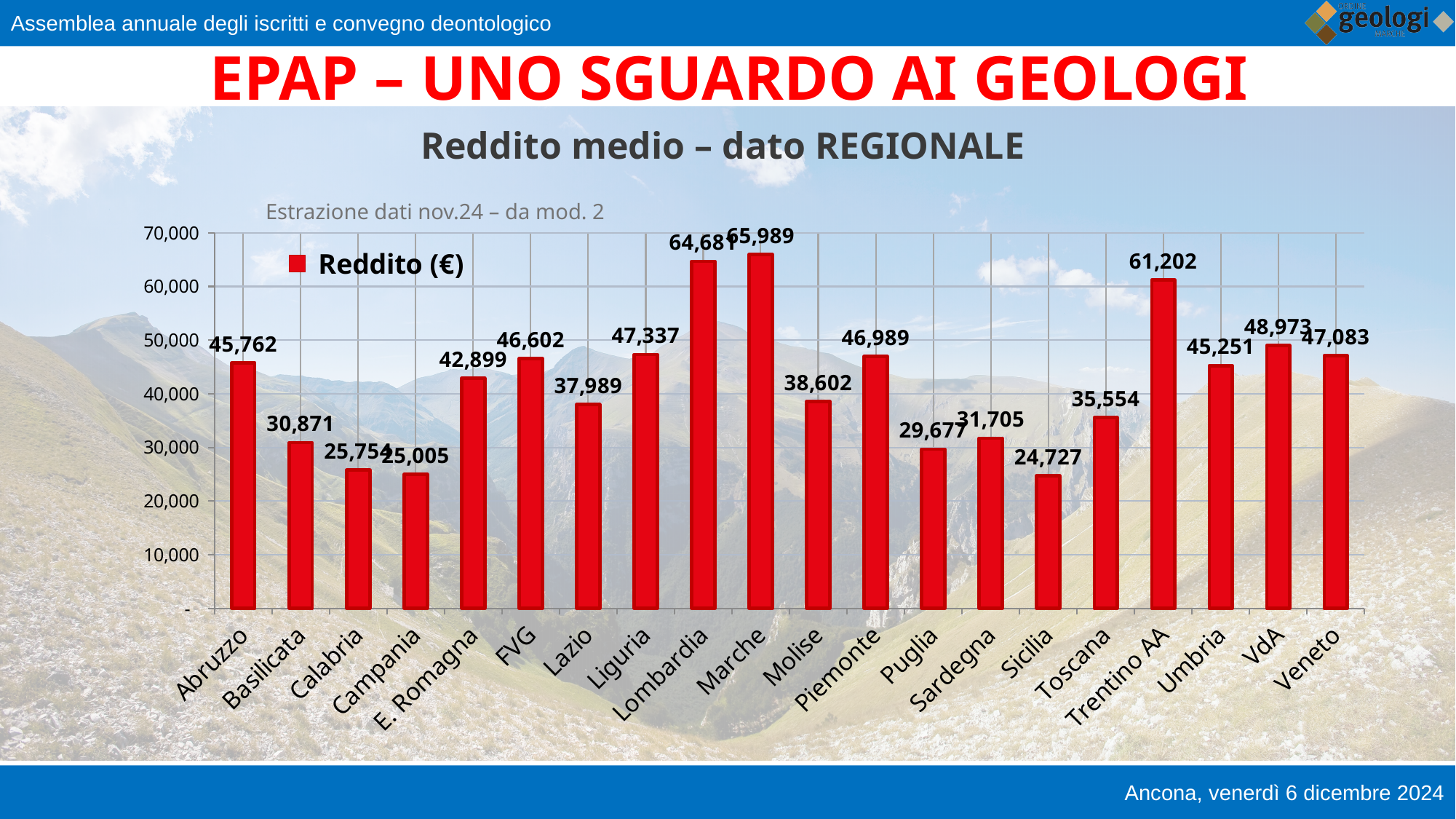
What is the difference between the values for Marche and Lombardia? 1,308 What is the value for Sardegna? 31,705 Which is larger, the value for Lombardia or the value for Trentino AA? Lombardia What is the value for Trentino AA? 61,202 What kind of chart is shown? bar chart Is the value for Toscana greater or less than 40,000? less Which region has the highest value? Marche Which region has the lowest value? Sicilia What is the title of the chart? Reddito medio – dato REGIONALE How many regions are shown on the x axis? 20 What is the difference between the values for Trentino AA and Umbria? 15,951 What is the value for Lombardia? 64,681